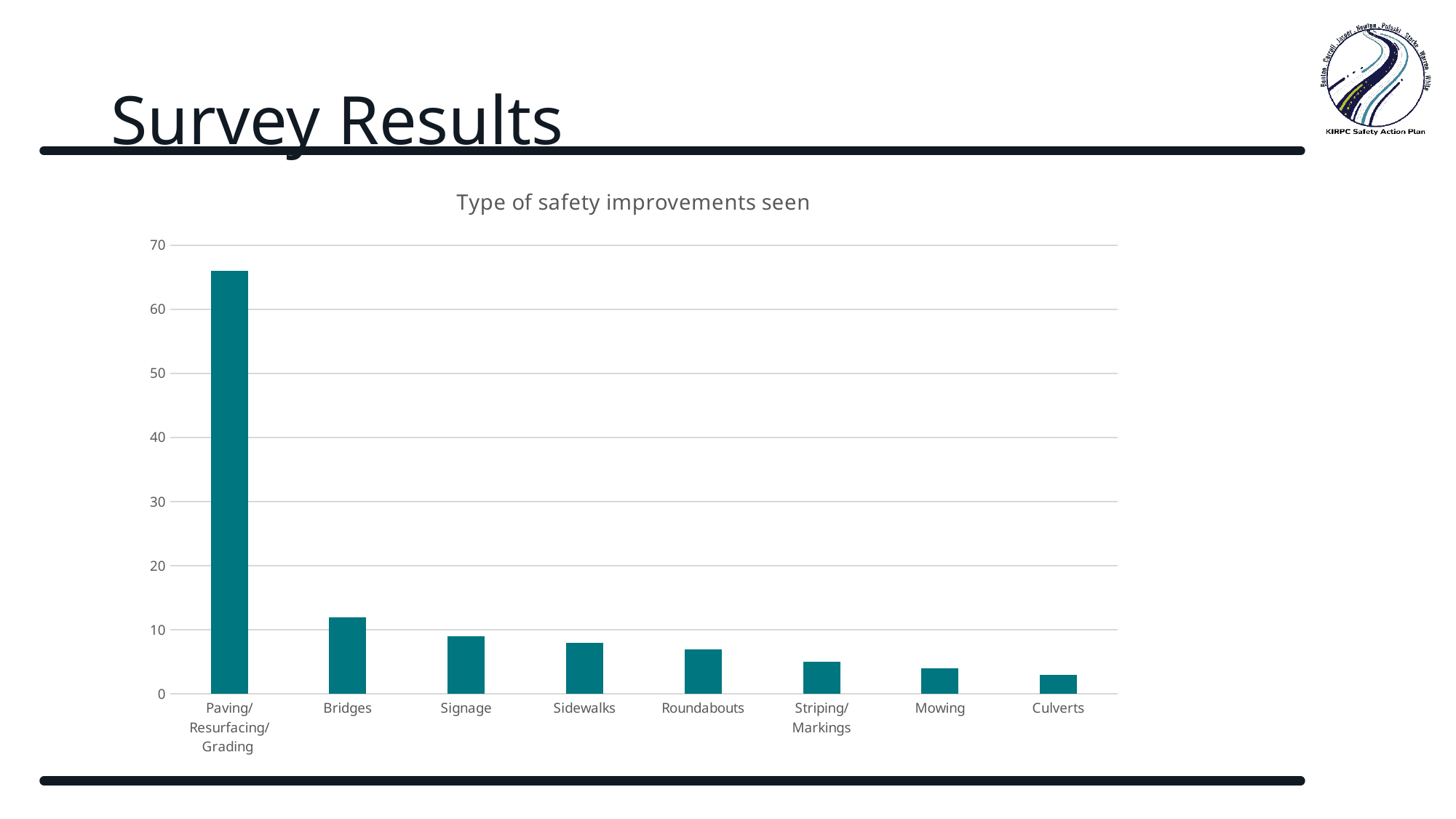
Which category has the highest value in the chart? Paving/Resurfacing/Grading Is the value for Bridges greater or less than 10? greater Is the value for Signage greater or less than 10? less Is the value for Paving/Resurfacing/Grading greater or less than 60? greater How many categories are shown on the x axis of the chart? 8 Which category has the lowest value in the chart? Culverts Which is larger, the value for Striping/Markings or the value for Culverts? Striping/Markings Do the values rise or fall moving from left to right along the x axis? fall What type of chart is shown on the slide? bar chart What is the title of the chart? Type of safety improvements seen Which is larger, the value for Bridges or the value for Roundabouts? Bridges